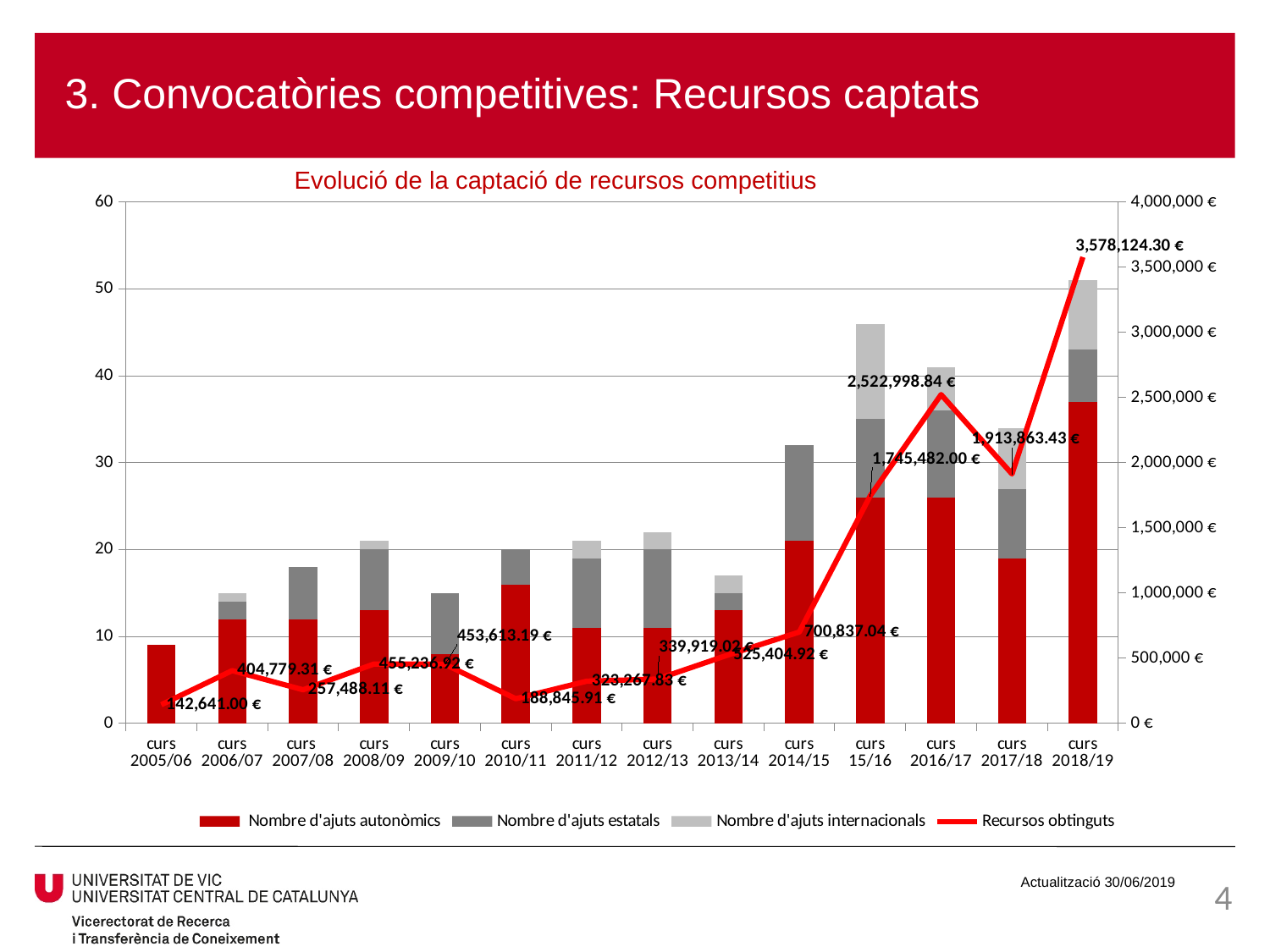
How many series does the chart legend list? 4 Is the total height of the stacked bar for curs 15/16 greater or less than 40? greater Which curs has the lowest value of Recursos obtinguts? curs 2005/06 What is the value of Recursos obtinguts for curs 2005/06? 142,641.00 € What is the value of Recursos obtinguts for curs 2010/11? 188,845.91 € What is the difference in Recursos obtinguts between curs 2016/17 and curs 2017/18? 609,135.41 € What kind of chart is shown on the slide? A combination chart of stacked bars and a line Which curs has the highest value of Recursos obtinguts? curs 2018/19 What is the value of Recursos obtinguts for curs 2018/19? 3,578,124.30 € How many academic years (curs) are shown on the x axis of the chart? 14 Which has a larger value of Recursos obtinguts, curs 2016/17 or curs 2017/18? curs 2016/17 What is the title of the chart? Evolució de la captació de recursos competitius